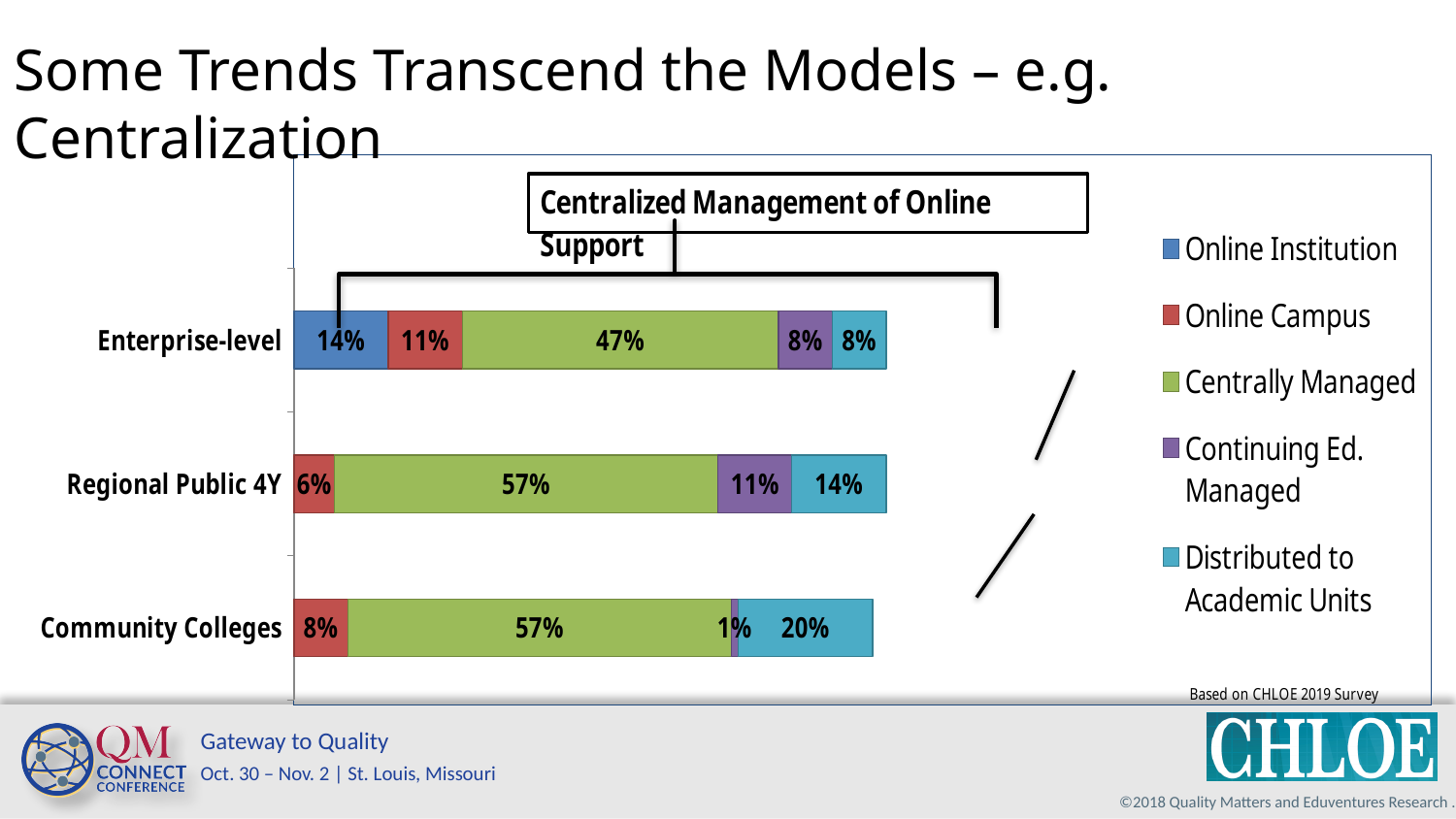
How many series does the legend list? 5 Which category has the lowest Continuing Ed. Managed value? Community Colleges Which is larger, the Online Campus value for Enterprise-level or for Community Colleges? Enterprise-level What is the difference between the Centrally Managed values for Regional Public 4Y and Enterprise-level? 10 percentage points What is the Online Institution value for Enterprise-level? 14% What is the Centrally Managed value for Enterprise-level? 47% How many categories are shown on the chart? 3 What kind of chart is shown on the slide? Stacked bar chart What is the Distributed to Academic Units value for Community Colleges? 20% Which category has the highest Distributed to Academic Units value? Community Colleges What is the Continuing Ed. Managed value for Regional Public 4Y? 11% What is the title of the chart? Centralized Management of Online Support